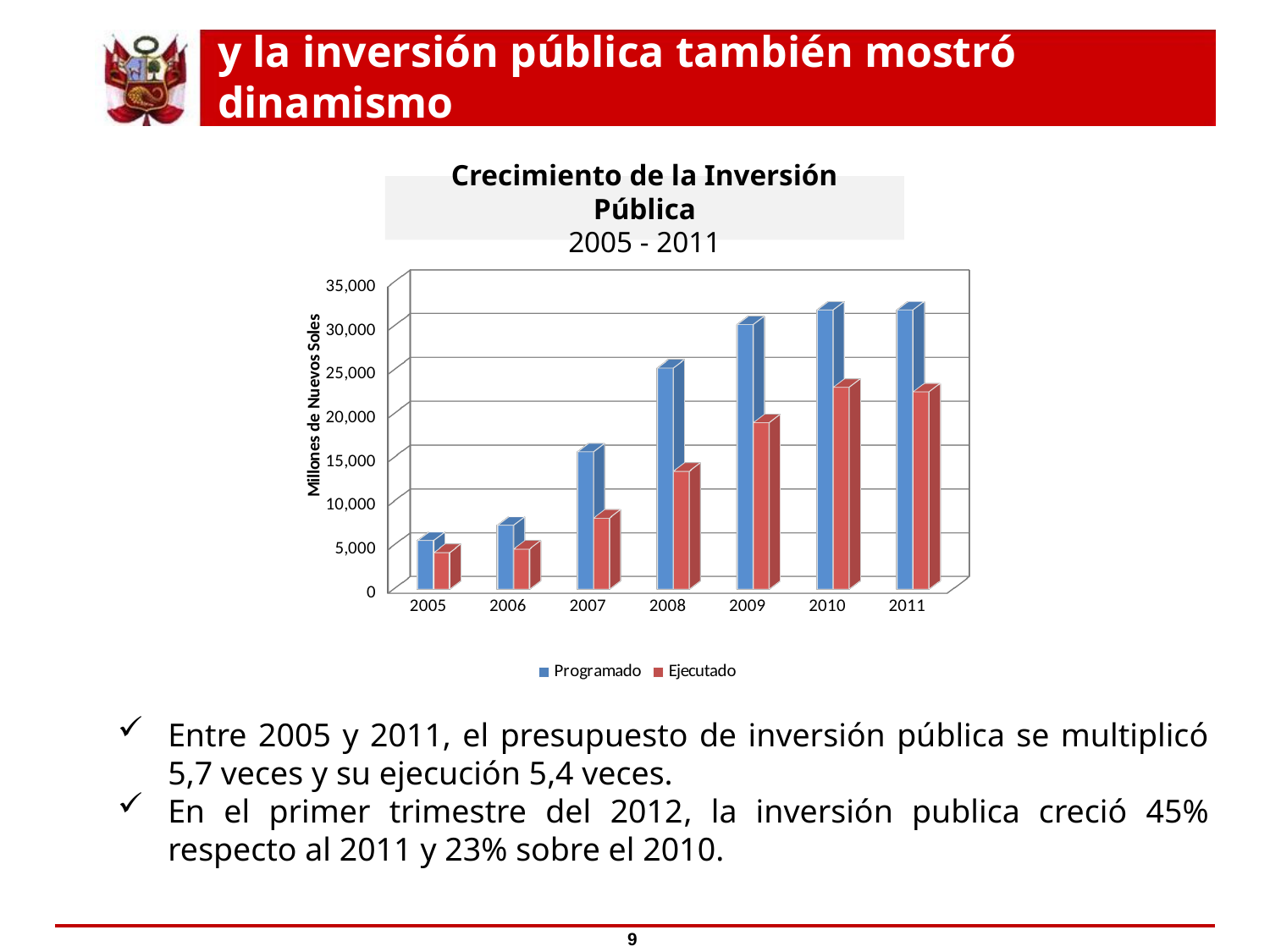
In 2008, which is larger, Programado or Ejecutado? Programado What kind of chart is shown on the slide? Bar chart Do the Programado values generally rise or fall from 2005 to 2010? rise Is the Programado value for 2008 greater or less than 20,000? greater Is the Ejecutado value for 2007 greater or less than 10,000? less How many years are shown on the x axis? 7 Is the Ejecutado value for 2010 greater or less than 20,000? greater How many series does the legend list? 2 Which is larger, the Ejecutado value for 2009 or for 2008? 2009 What is the label on the vertical axis? Millones de Nuevos Soles Which year has the lowest Programado value? 2005